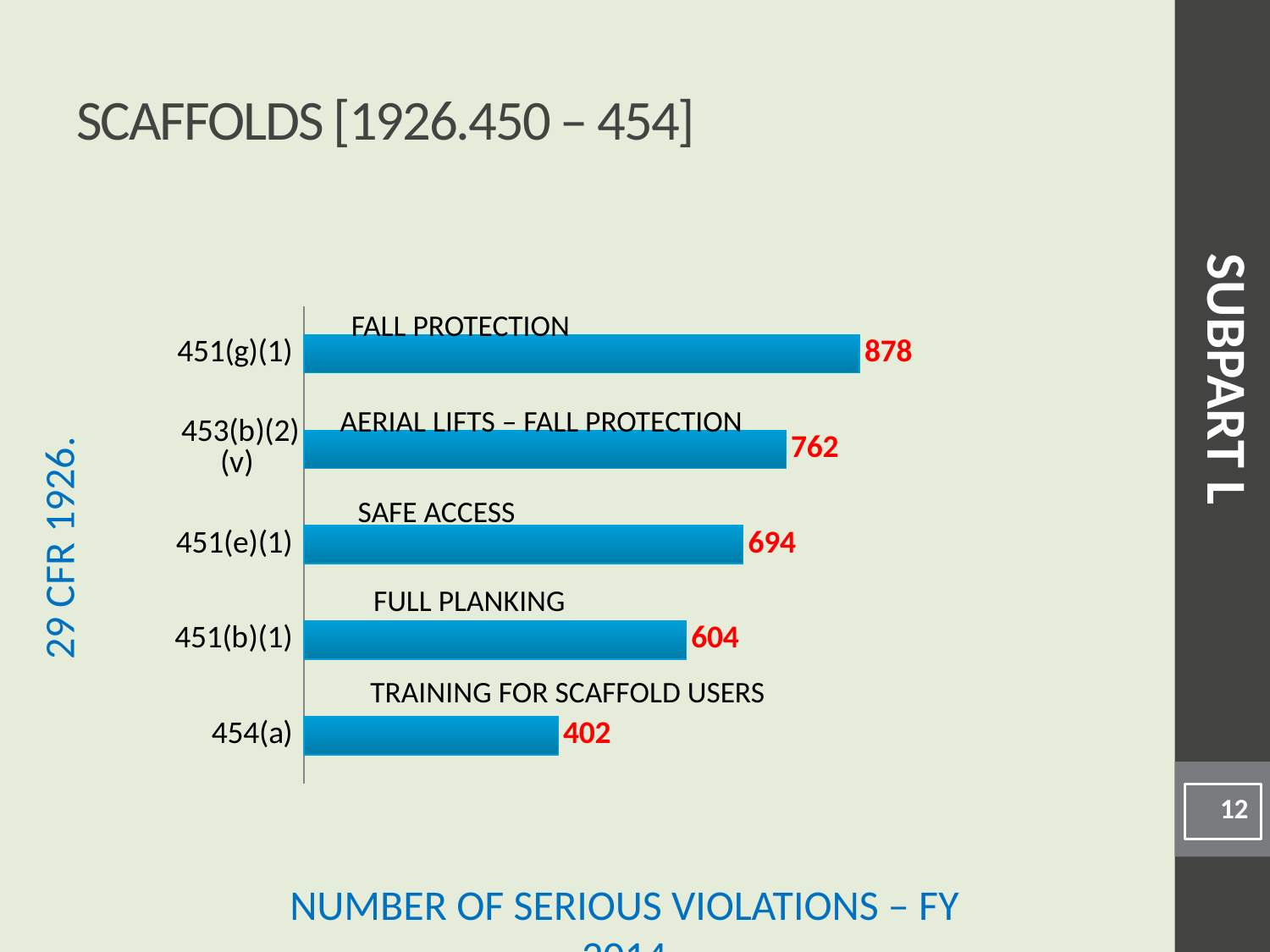
What is the number of serious violations for 454(a) (Training for Scaffold Users)? 402 Which category has the lowest number of serious violations? 454(a) (Training for Scaffold Users) What is the difference between the violations for 453(b)(2)(v) and 451(e)(1)? 68 What is the number of serious violations for 451(g)(1) (Fall Protection)? 878 Which category has the highest number of serious violations? 451(g)(1) (Fall Protection) What is the number of serious violations for 453(b)(2)(v) (Aerial Lifts – Fall Protection)? 762 Which has more serious violations, 451(e)(1) or 451(b)(1)? 451(e)(1) How many categories are shown in the chart? 5 What type of chart is shown on the slide? Bar chart What is the number of serious violations for 451(e)(1) (Safe Access)? 694 What is the number of serious violations for 451(b)(1) (Full Planking)? 604 What is the difference between the violations for 451(g)(1) and 454(a)? 476